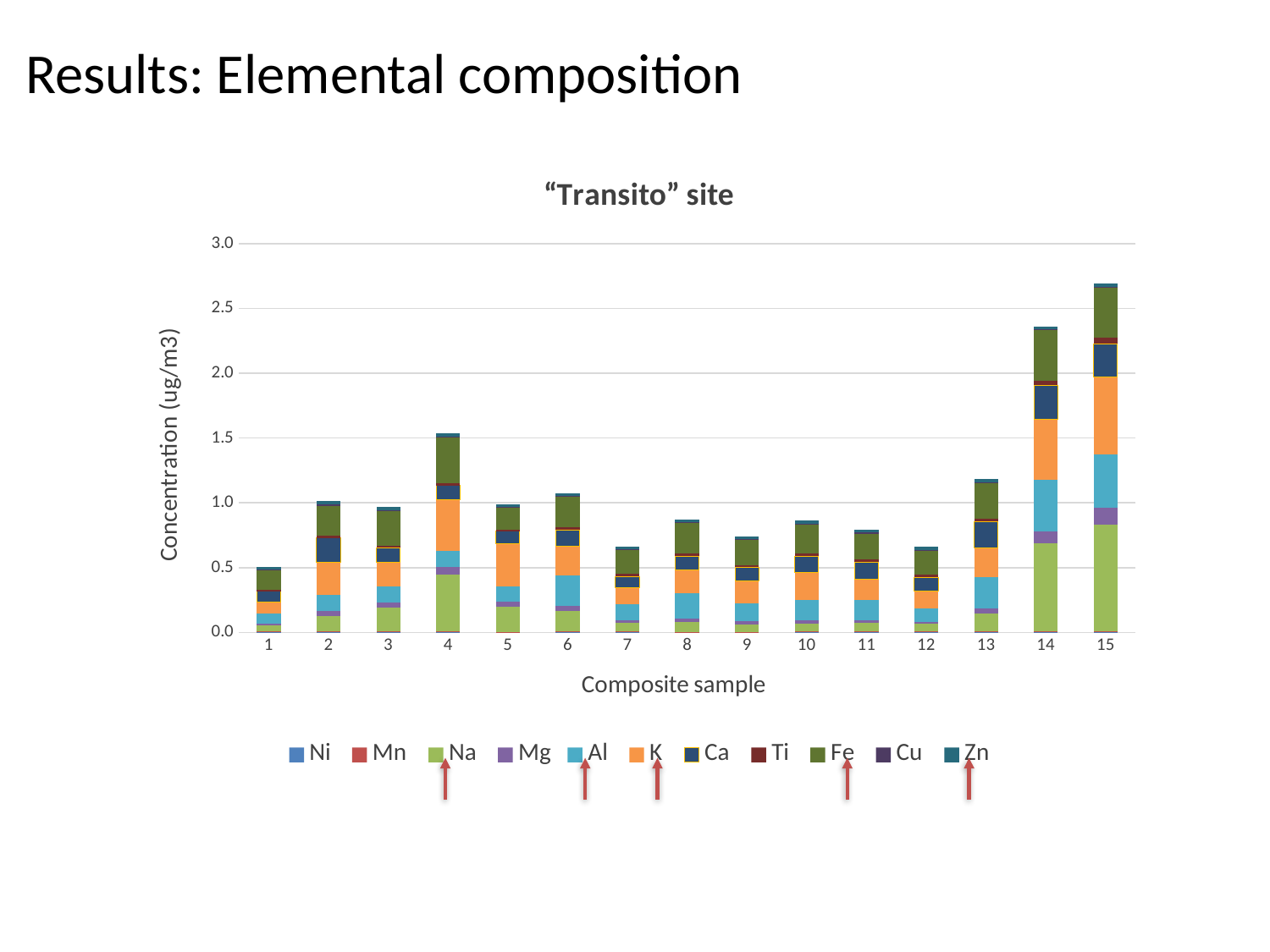
Is the total concentration for composite sample 15 greater or less than 2.5? greater What is the label of the y axis? Concentration (ug/m3) Is the total concentration for composite sample 7 greater or less than 1.0? less Is the total concentration for composite sample 14 greater or less than 2.0? greater How many series does the legend list? 11 What kind of chart is shown on the slide? Stacked bar chart Which has the larger total concentration, composite sample 4 or composite sample 5? 4 Which composite sample has the lowest total concentration? 1 Which composite sample has the highest total concentration? 15 How many composite samples are plotted along the x axis? 15 What is the title of the chart? "Transito" site